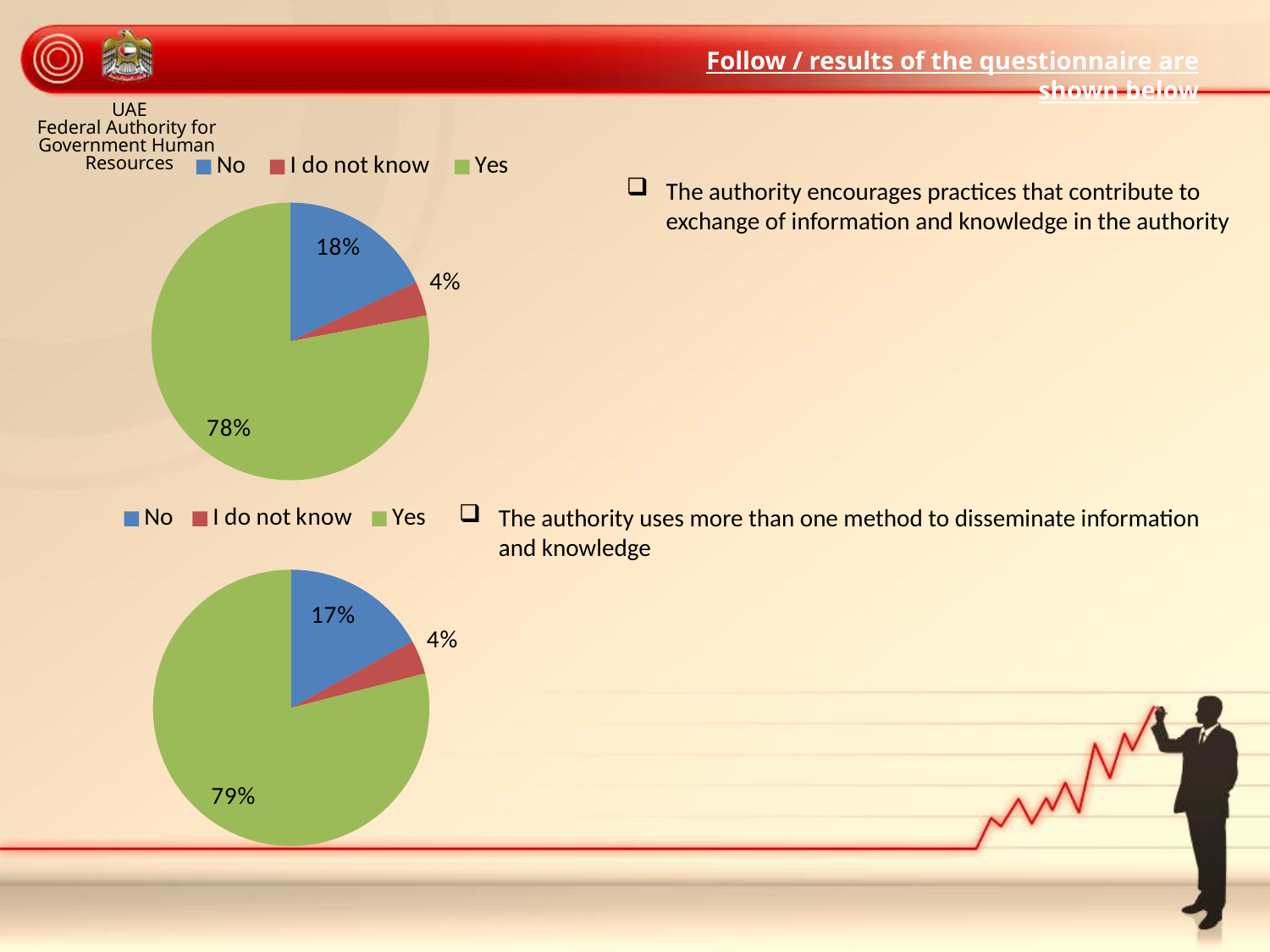
How many slices does the bottom pie chart have? 3 In the bottom pie chart, what percentage of respondents answered No? 17% In the top pie chart, what colour represents the Yes response? Green In the top pie chart, which response has the largest share? Yes In the bottom pie chart, which is larger, the share for No or the share for I do not know? No In the top pie chart, what is the difference between the Yes and No percentages? 60% What type of chart is the top chart on the slide? Pie chart In the bottom pie chart, which response has the smallest share? I do not know In the top pie chart, what percentage of respondents answered I do not know? 4% In the top pie chart, what percentage of respondents answered Yes? 78% In the top pie chart, what percentage of respondents answered No? 18% In the bottom pie chart, what percentage of respondents answered Yes? 79%